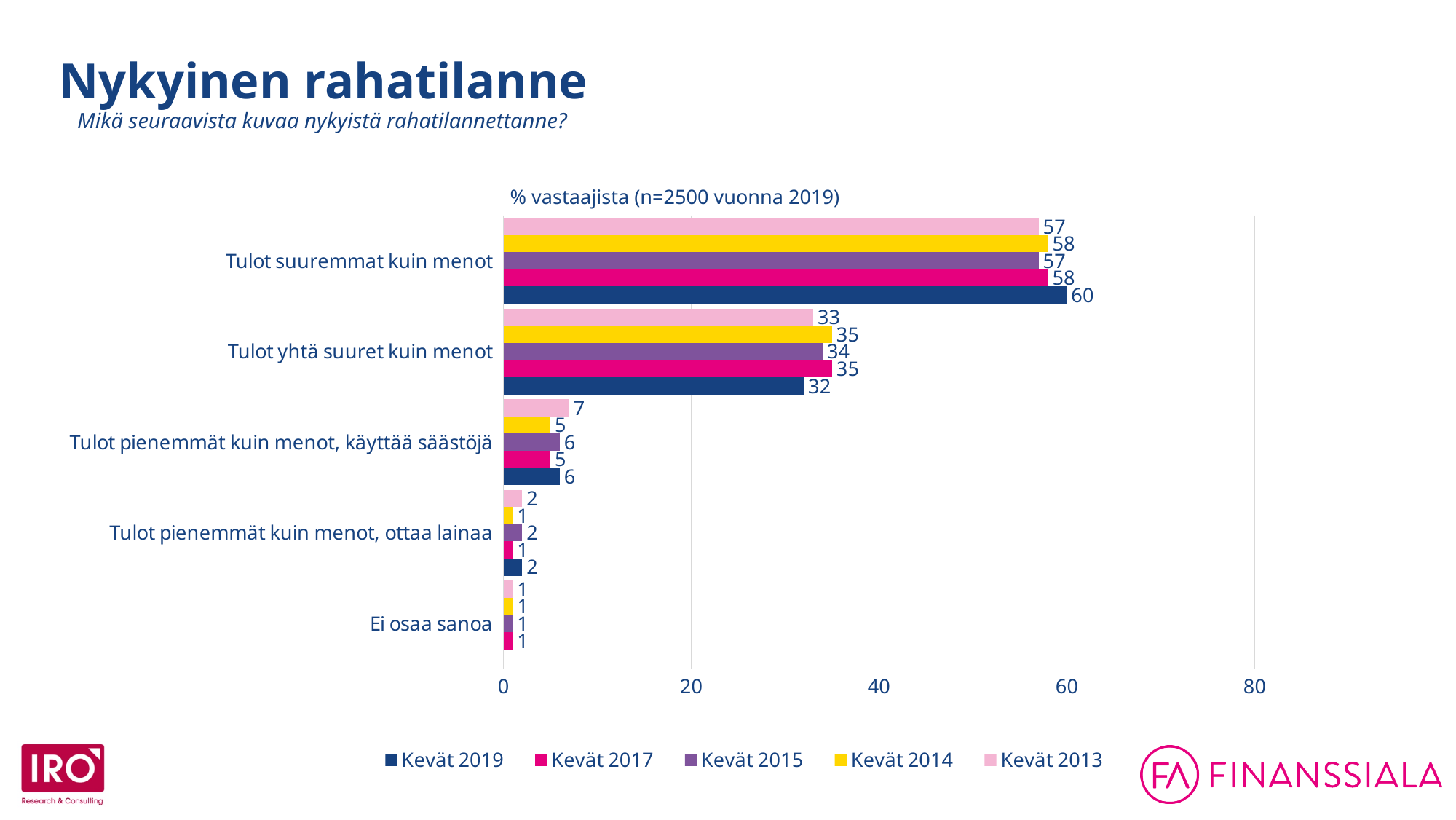
What is the difference between the Kevät 2019 and Kevät 2013 values for 'Tulot suuremmat kuin menot'? 3 What is the value for 'Tulot pienemmät kuin menot, ottaa lainaa' in the Kevät 2015 series? 2 For 'Tulot yhtä suuret kuin menot', which is larger: the Kevät 2017 value or the Kevät 2019 value? Kevät 2017 What kind of chart is shown on the slide? bar chart How many categories are shown on the chart? 5 Which category has the highest value in the Kevät 2019 series? Tulot suuremmat kuin menot Which category has the lowest value in the Kevät 2013 series? Ei osaa sanoa What is the value for 'Tulot yhtä suuret kuin menot' in the Kevät 2014 series? 35 How many series does the legend list? 5 What is the title printed above the chart's plot area? % vastaajista (n=2500 vuonna 2019) What is the value for 'Tulot pienemmät kuin menot, käyttää säästöjä' in the Kevät 2013 series? 7 What is the value for 'Tulot suuremmat kuin menot' in the Kevät 2019 series? 60